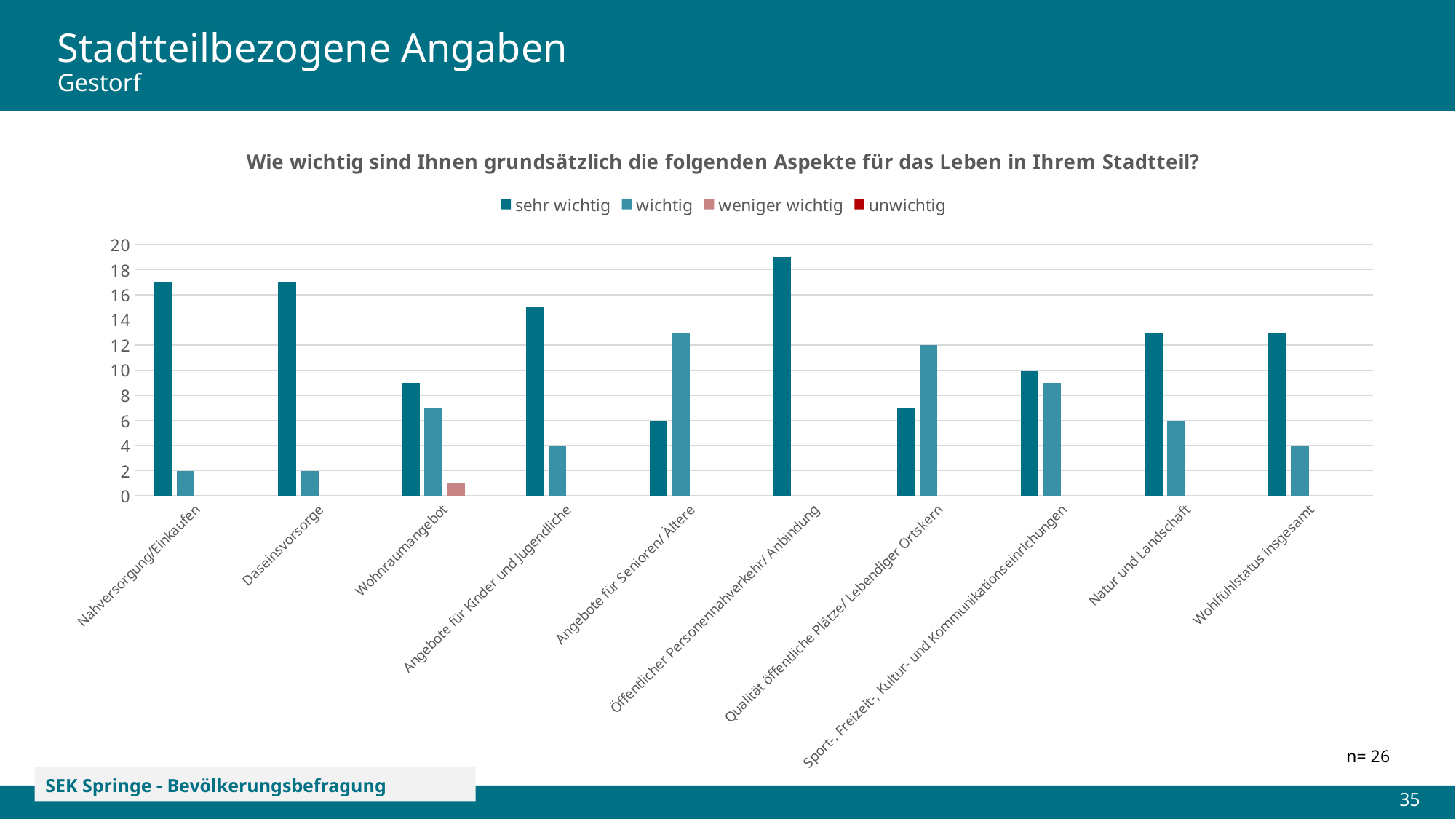
Which category is the only one with a visible 'weniger wichtig' bar? Wohnraumangebot How many categories are shown on the x axis? 10 What is the 'wichtig' value for Natur und Landschaft? 6 How many series does the legend list? 4 What is the 'sehr wichtig' value for Sport-, Freizeit-, Kultur- und Kommunikationseinrichtungen? 10 What is the 'wichtig' value for Qualität öffentliche Plätze/ Lebendiger Ortskern? 12 Is the 'sehr wichtig' value for Öffentlicher Personennahverkehr/ Anbindung greater or less than 18? greater What type of chart is shown on the slide? bar chart Which category has the lowest 'sehr wichtig' value? Angebote für Senioren/ Ältere What is the difference between the 'wichtig' value for Qualität öffentliche Plätze/ Lebendiger Ortskern and the 'wichtig' value for Wohlfühlstatus insgesamt? 8 For Angebote für Senioren/ Ältere, which is larger: the 'sehr wichtig' value or the 'wichtig' value? wichtig Which category has the highest 'sehr wichtig' value? Öffentlicher Personennahverkehr/ Anbindung